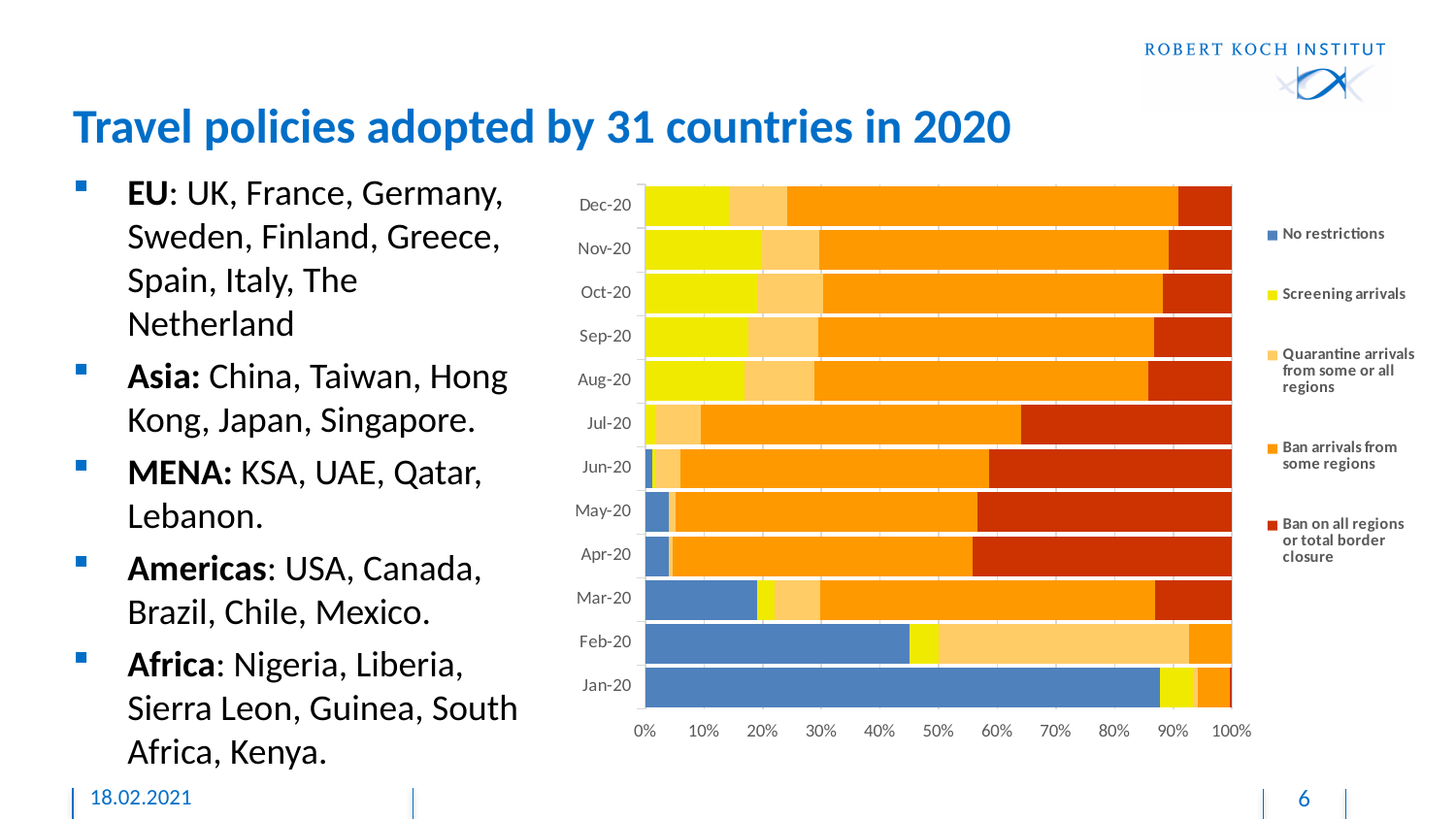
Which legend entry is shown in yellow? Screening arrivals How many series does the chart legend list? 5 Is the 'No restrictions' share for Mar-20 greater or less than 10%? greater Which month has the smallest 'Ban on all regions or total border closure' share? Feb-20 Is the 'No restrictions' share for Apr-20 greater or less than 10%? less How many months are shown on the vertical axis of the chart? 12 What kind of chart is shown on the slide? Stacked bar chart Is the 'No restrictions' share for Jan-20 greater or less than 80%? greater Which month has the largest 'No restrictions' share? Jan-20 Which month has a larger 'No restrictions' share, Jan-20 or Feb-20? Jan-20 Does the 'No restrictions' share rise or fall from Jan-20 to Apr-20? fall